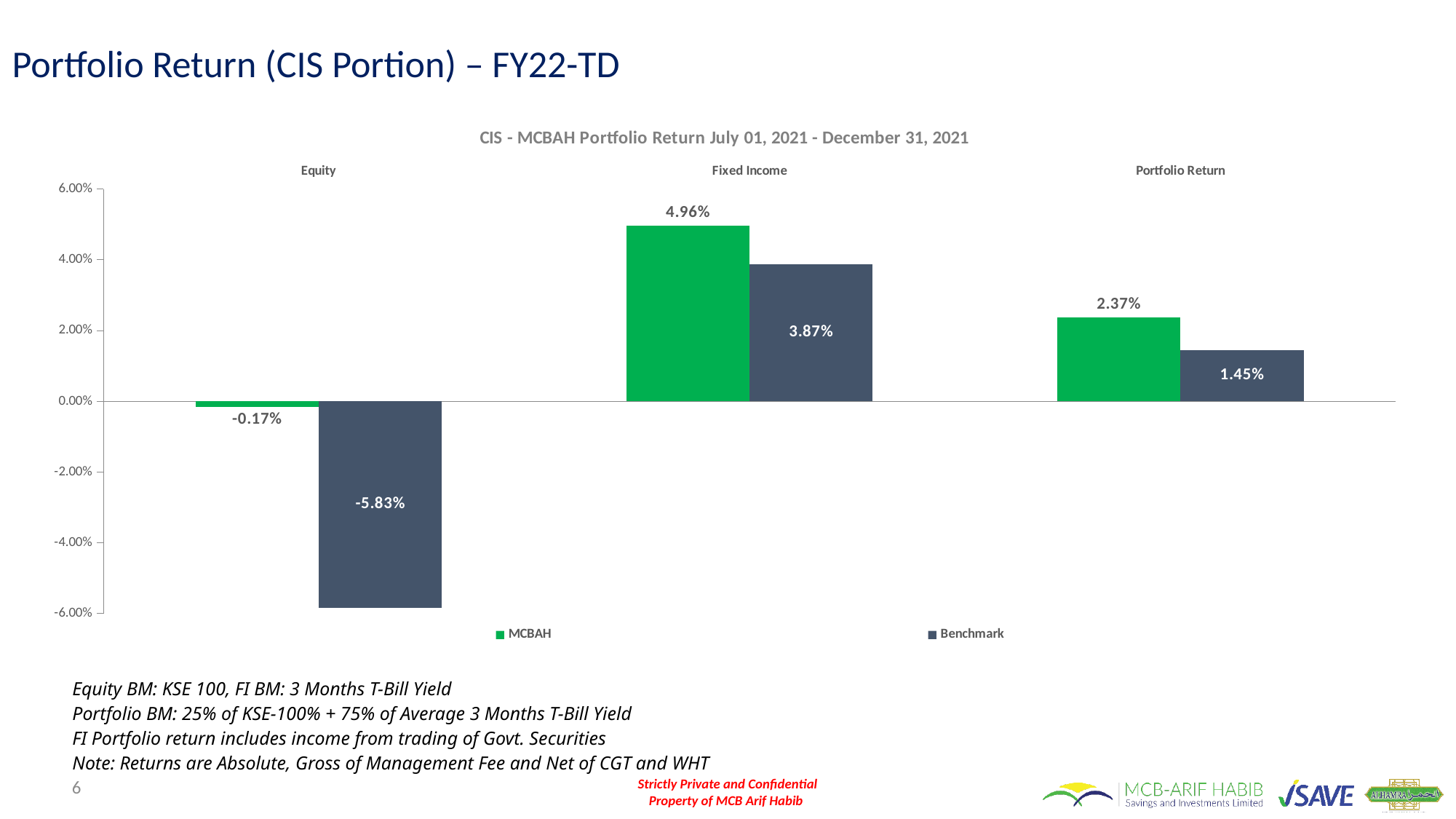
Which is larger for Portfolio Return, the MCBAH value or the Benchmark value? MCBAH What kind of chart is shown on the slide? Bar chart Which category has the lowest Benchmark value? Equity What is the MCBAH value for Equity? -0.17% What is the Benchmark value for Portfolio Return? 1.45% How many series does the legend list? 2 What is the MCBAH value for Portfolio Return? 2.37% What is the difference between the MCBAH and Benchmark values for Fixed Income? 1.09% How many categories are shown on the x axis? 3 What is the MCBAH value for Fixed Income? 4.96% What is the Benchmark value for Equity? -5.83% Which category has the highest MCBAH value? Fixed Income